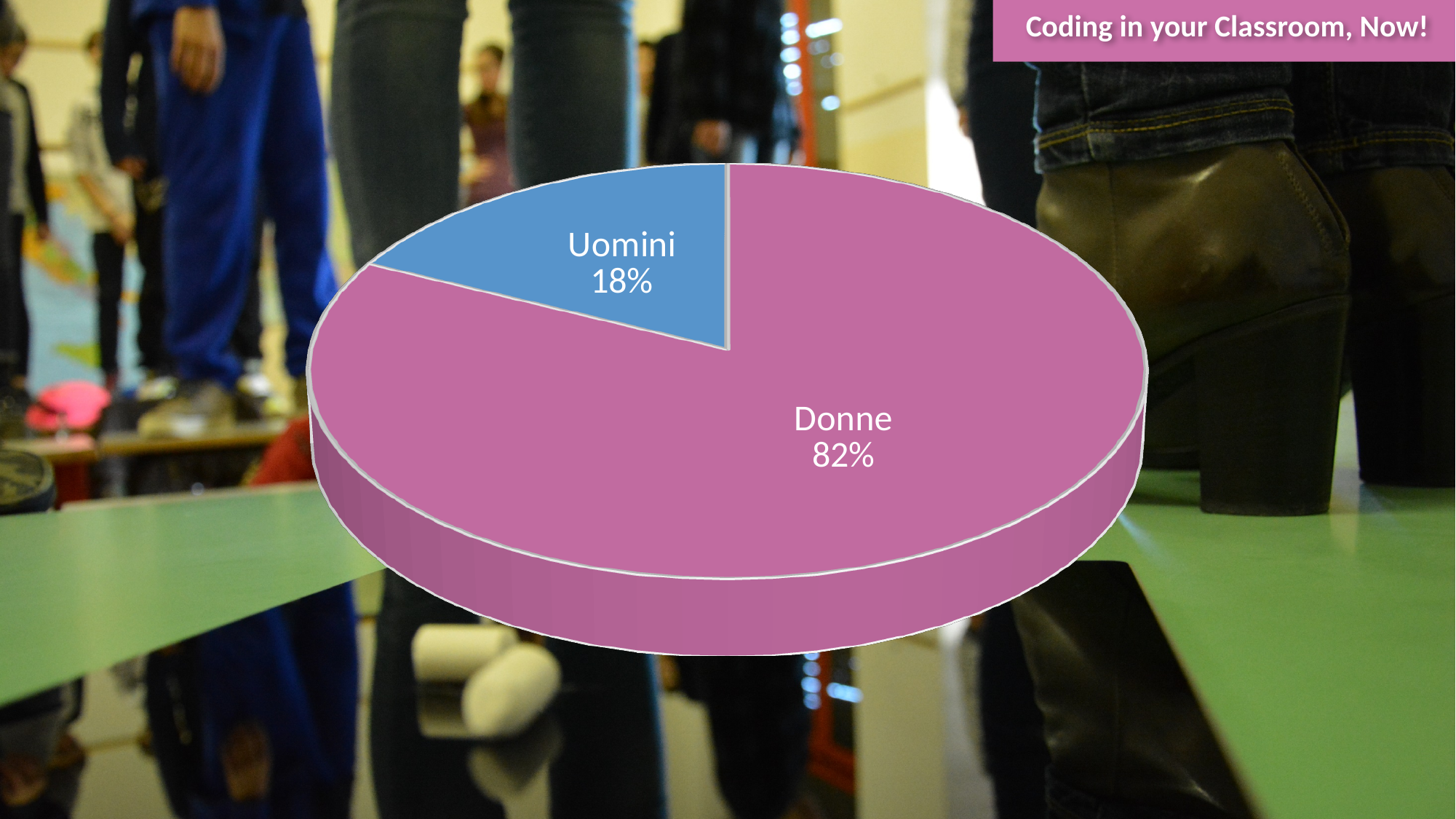
Which slice of the pie is the smallest? Uomini What colour is the Donne slice? pink Which slice of the pie is the largest? Donne How many slices does the pie chart have? 2 What share of the pie does Donne represent? 82% What colour is the Uomini slice? blue What is the difference in percentage points between the Donne and Uomini slices? 64 What share of the pie does Uomini represent? 18% What kind of chart is shown on the slide? pie chart Which is larger, the Donne slice or the Uomini slice? Donne